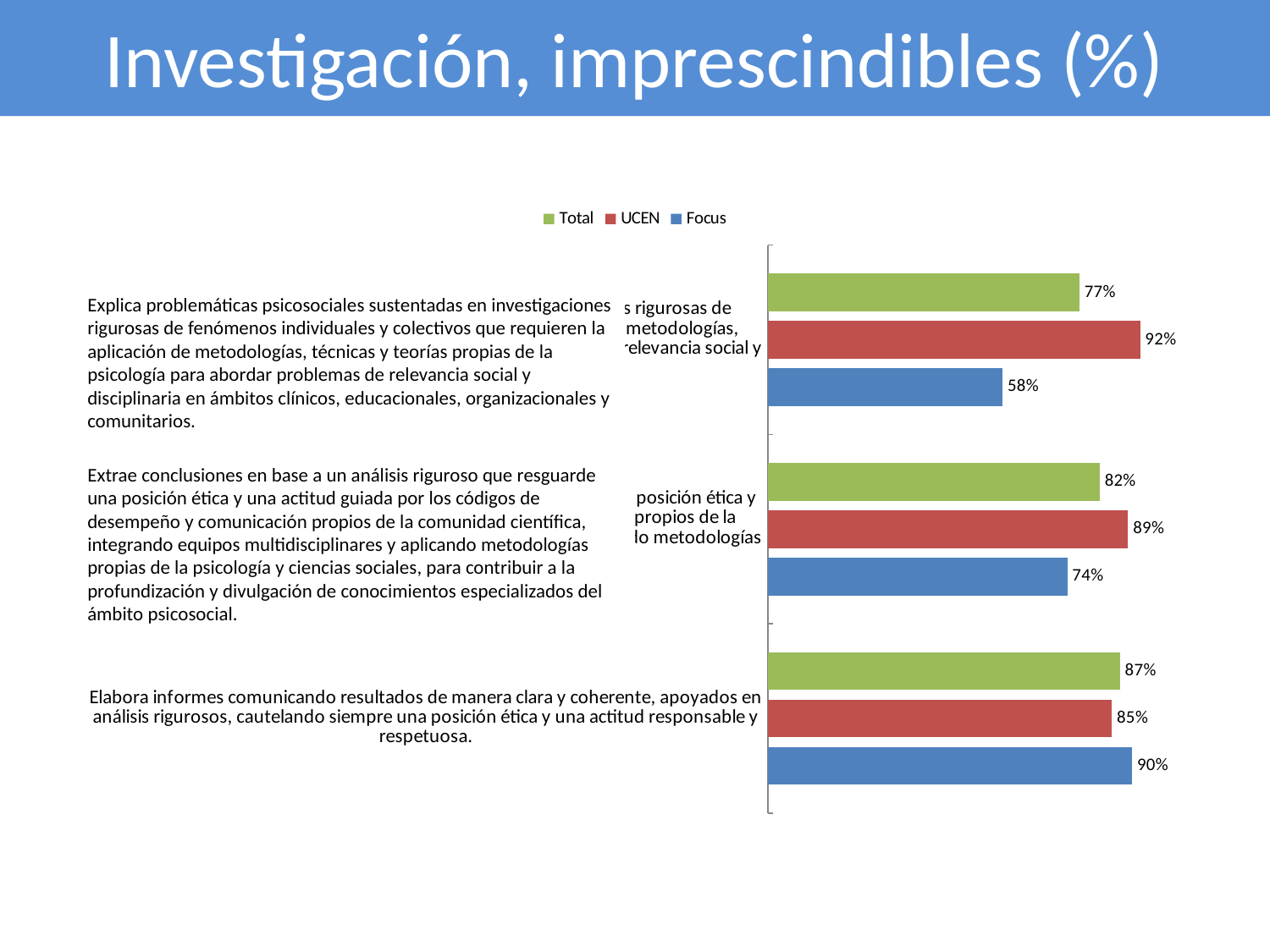
How many categories are plotted in the chart? 3 What is the UCEN value for the category beginning "Explica problemáticas psicosociales"? 92% How many series does the legend list? 3 For the category beginning "Elabora informes", which is larger, the Total value or the UCEN value? Total What is the Focus value for the category beginning "Elabora informes"? 90% What is the Focus value for the category beginning "Explica problemáticas psicosociales"? 58% What is the difference between the UCEN and Focus values for the category beginning "Explica problemáticas psicosociales"? 34% What is the Total value for the category beginning "Extrae conclusiones"? 82% Which series is shown in green in the legend? Total Which category has the lowest Focus value? Explica problemáticas psicosociales sustentadas en investigaciones rigurosas... Which category has the highest UCEN value? Explica problemáticas psicosociales sustentadas en investigaciones rigurosas... What kind of chart is shown on the slide? Bar chart